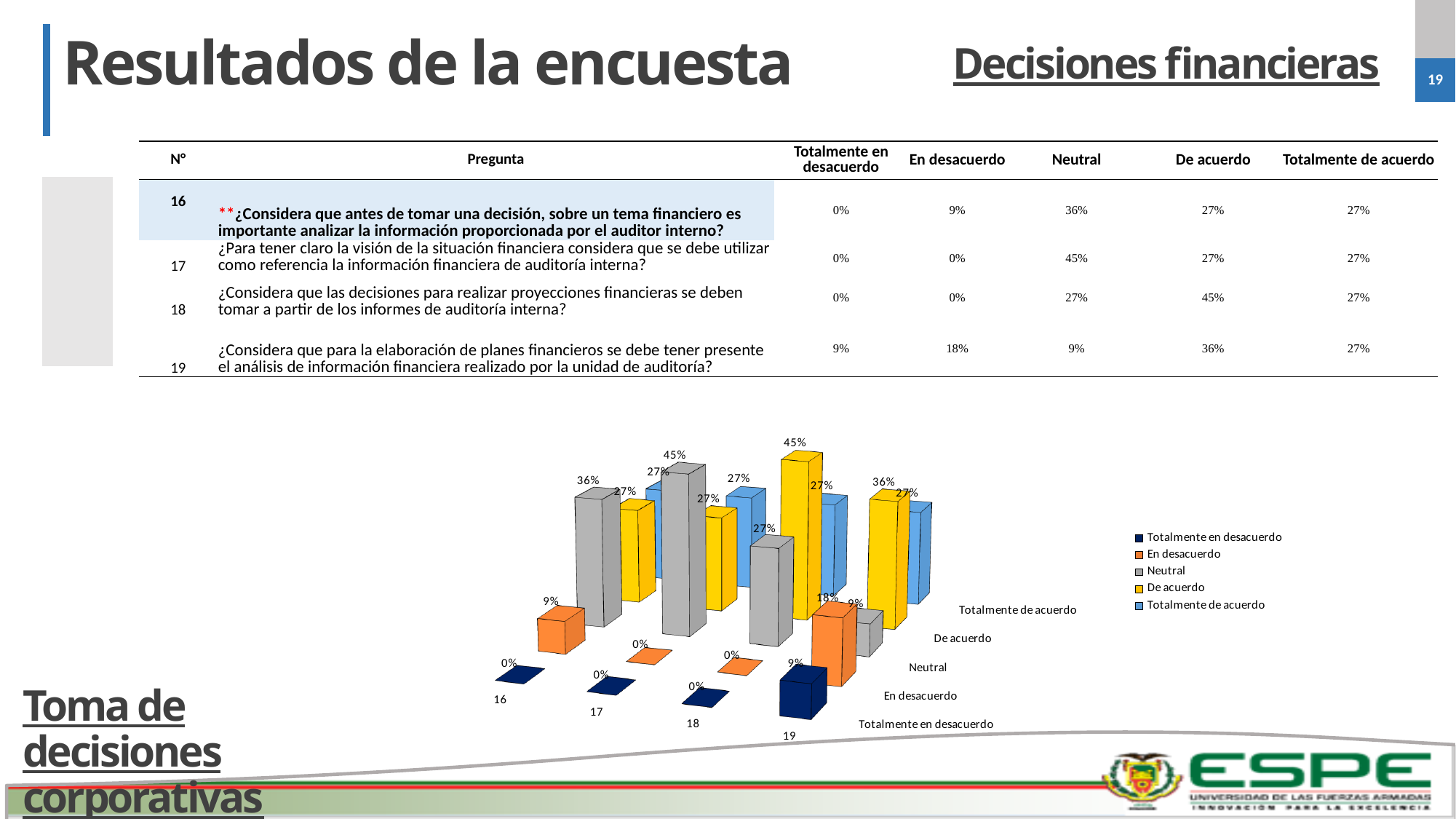
Which series in the chart legend is shown in yellow? De acuerdo What is the De acuerdo value for question 18 in the chart? 45% What is the Neutral value for question 17 in the chart? 45% Which is larger for question 18: the Neutral value or the De acuerdo value? De acuerdo Which question has the highest En desacuerdo value in the chart? 19 What is the En desacuerdo value for question 19 in the chart? 18% What kind of chart is shown on the slide? bar chart What is the difference between the Neutral value for question 16 and the Neutral value for question 19? 27% Which question has the highest Neutral value in the chart? 17 How many question numbers are shown along the x axis of the chart? 4 How many series does the chart legend list? 5 What is the Totalmente en desacuerdo value for question 19 in the chart? 9%